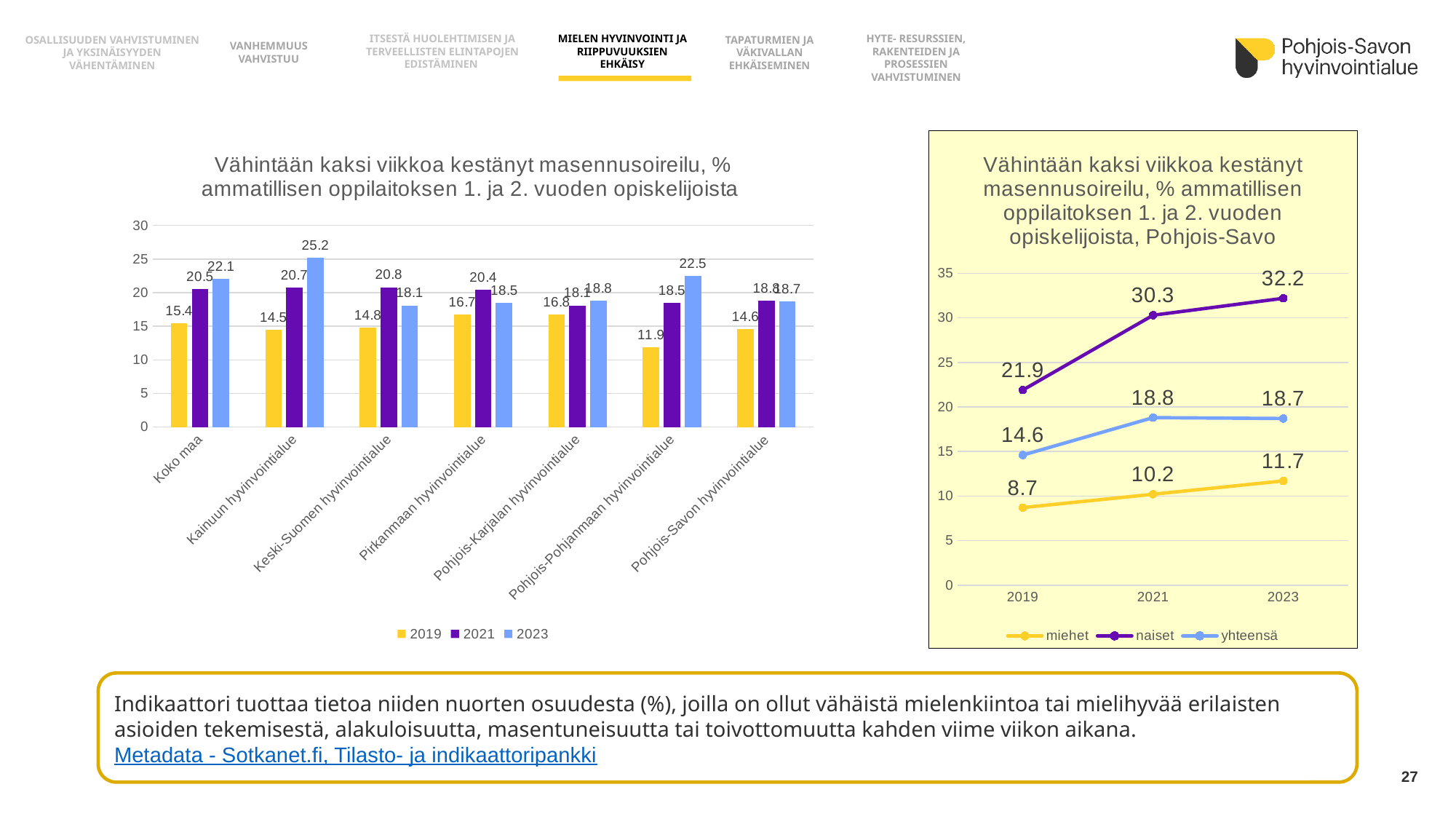
In the left bar chart, how many regions are shown on the x axis? 7 In the left bar chart, what is the 2019 value for Pohjois-Pohjanmaan hyvinvointialue? 11.9 In the left bar chart, which region has the lowest 2019 value? Pohjois-Pohjanmaan hyvinvointialue In the right line chart for Pohjois-Savo, what is the difference between naiset and miehet in 2023? 20.5 In the left bar chart, which region has the highest 2023 value? Kainuun hyvinvointialue In the left bar chart, what is the difference between the 2023 and 2019 values for Koko maa? 6.7 In the right line chart for Pohjois-Savo, what is the value for naiset in 2021? 30.3 In the right line chart for Pohjois-Savo, which series is shown in purple? naiset What kind of chart is the chart on the left of the slide? Bar chart In the left bar chart, how many series does the legend list? 3 In the left bar chart, what is the 2023 value for Kainuun hyvinvointialue? 25.2 In the right line chart for Pohjois-Savo, do the values for miehet rise or fall from 2019 to 2023? Rise